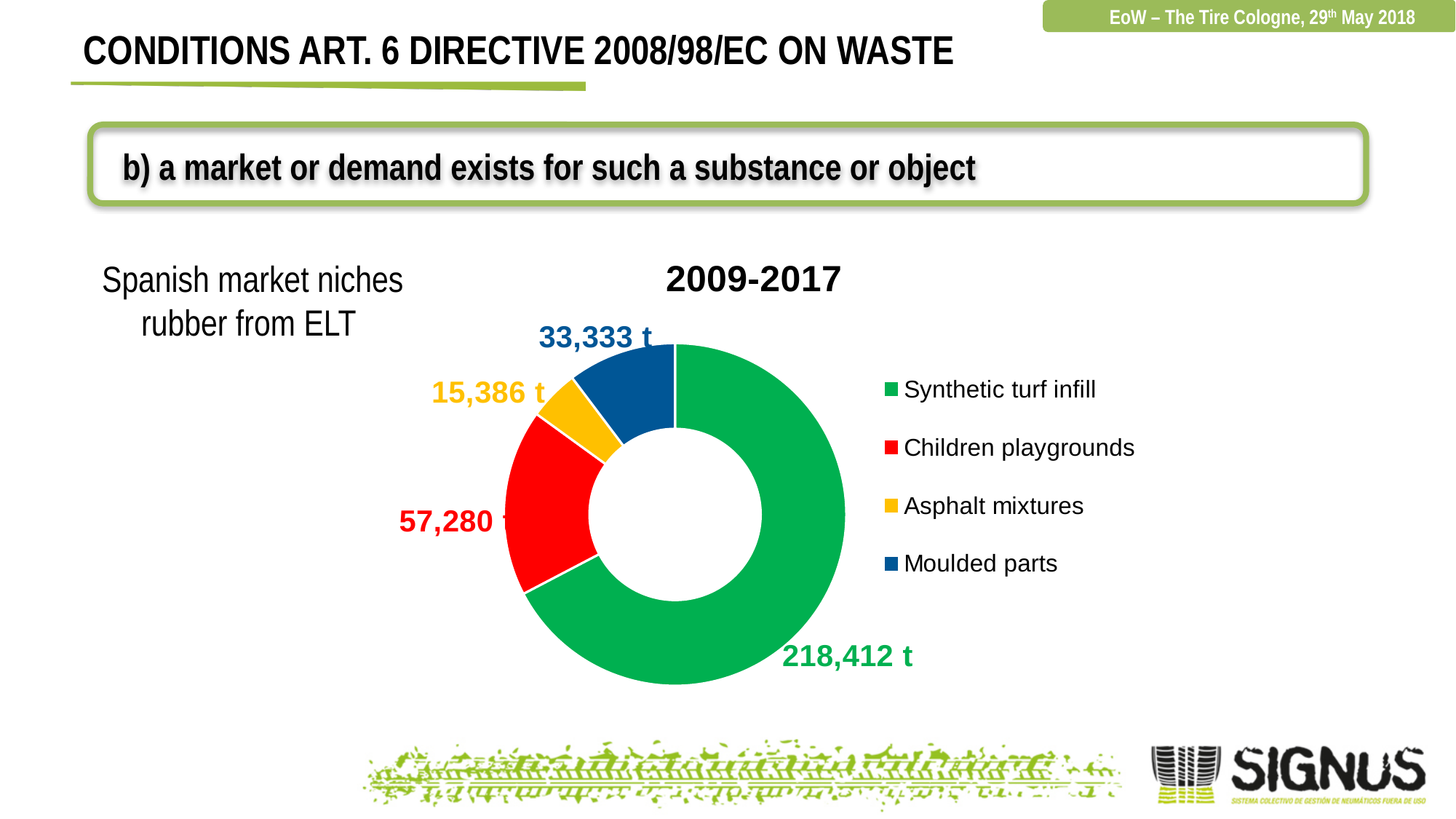
Which category has the smallest value in the 2009-2017 chart? Asphalt mixtures What is the value for Children playgrounds in the 2009-2017 chart? 57,280 t Which is larger in the 2009-2017 chart: Children playgrounds or Moulded parts? Children playgrounds What is the difference between Synthetic turf infill and Children playgrounds in the 2009-2017 chart? 161,132 t What is the value for Moulded parts in the 2009-2017 chart? 33,333 t What is the value for Asphalt mixtures in the 2009-2017 chart? 15,386 t Which category has the largest value in the 2009-2017 chart? Synthetic turf infill What is the difference between Moulded parts and Asphalt mixtures in the 2009-2017 chart? 17,947 t How many categories are shown in the 2009-2017 chart? 4 What colour represents Asphalt mixtures in the 2009-2017 chart? Yellow What kind of chart is the 2009-2017 chart? Doughnut chart What is the value for Synthetic turf infill in the 2009-2017 chart? 218,412 t